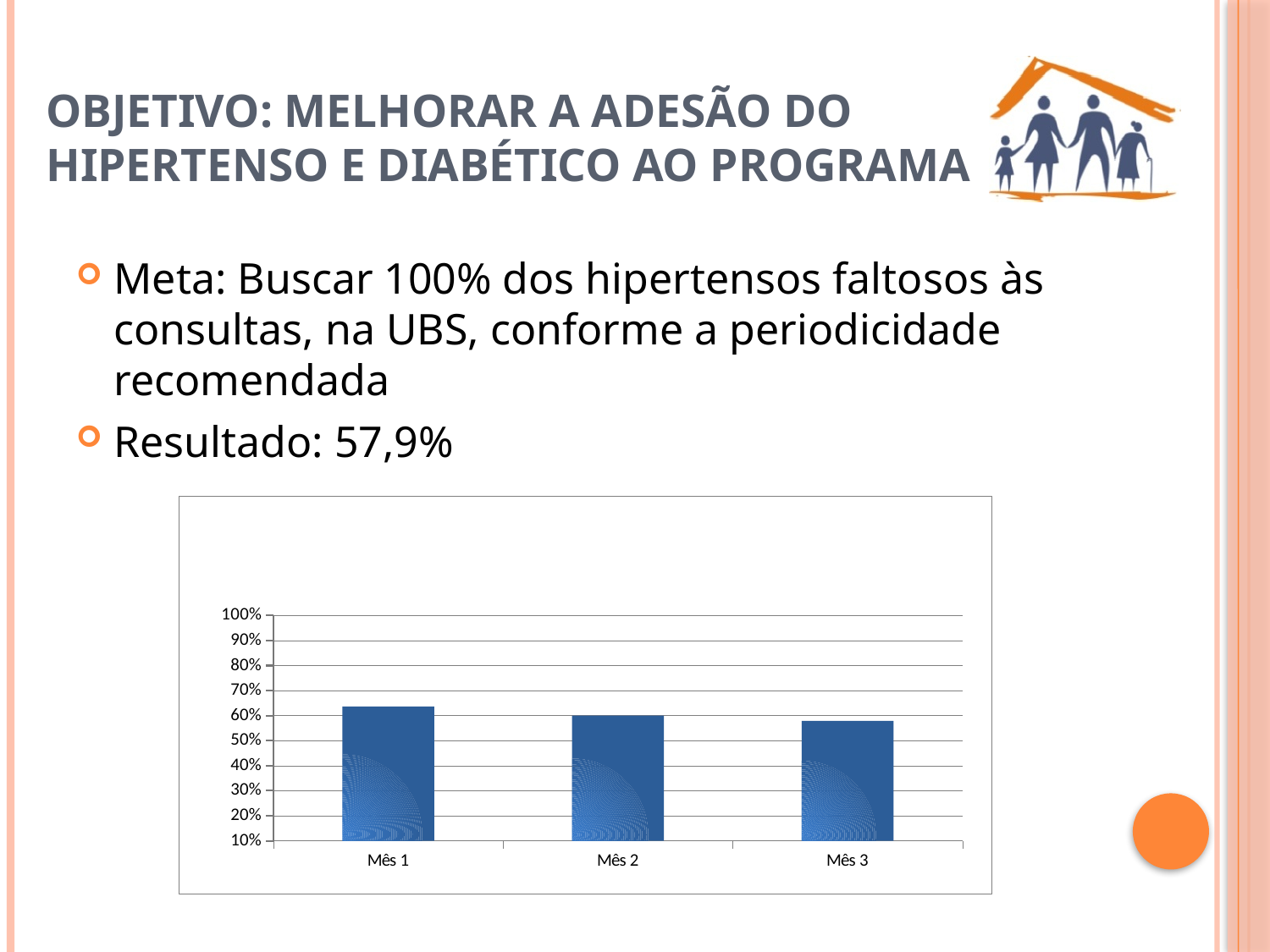
Is the value for Mês 1 greater or less than 70%? less Which month has the highest bar on the chart? Mês 1 What are the category labels on the chart's horizontal axis? Mês 1, Mês 2, Mês 3 What is the highest value shown on the chart's vertical axis? 100% Is the value for Mês 1 greater or less than 60%? greater Do the values rise or fall from Mês 1 to Mês 3? fall Which is larger, the value for Mês 1 or the value for Mês 3? Mês 1 Which month has the lowest bar on the chart? Mês 3 What kind of chart is shown on the slide? bar chart Is the value for Mês 3 greater or less than 50%? greater How many categories (months) are plotted on the chart? 3